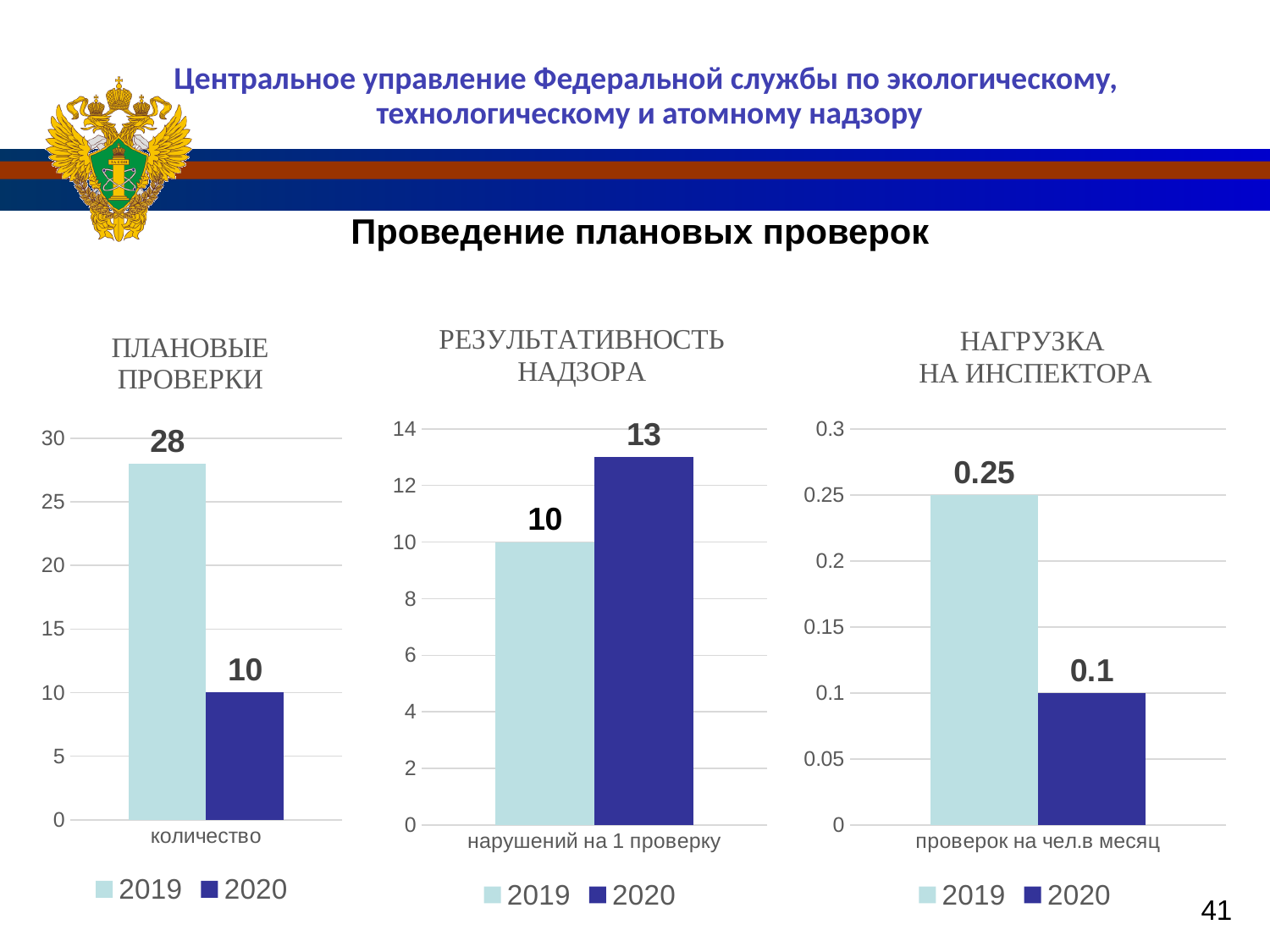
In the chart titled "РЕЗУЛЬТАТИВНОСТЬ НАДЗОРА", what is the difference between the 2020 and 2019 values? 3 In the chart titled "РЕЗУЛЬТАТИВНОСТЬ НАДЗОРА", what is the value for 2020? 13 In the chart titled "ПЛАНОВЫЕ ПРОВЕРКИ", what is the value for 2019? 28 In the chart titled "РЕЗУЛЬТАТИВНОСТЬ НАДЗОРА", which year has the higher value? 2020 How many series does the legend list in the chart titled "ПЛАНОВЫЕ ПРОВЕРКИ"? 2 In the chart titled "НАГРУЗКА НА ИНСПЕКТОРА", what is the category label on the x axis? проверок на чел.в месяц In the chart titled "ПЛАНОВЫЕ ПРОВЕРКИ", what is the difference between the 2019 and 2020 values? 18 In the chart titled "НАГРУЗКА НА ИНСПЕКТОРА", what is the value for 2019? 0.25 In the chart titled "ПЛАНОВЫЕ ПРОВЕРКИ", what is the value for 2020? 10 In the chart titled "НАГРУЗКА НА ИНСПЕКТОРА", which year has the lower value? 2020 What kind of chart is the chart titled "РЕЗУЛЬТАТИВНОСТЬ НАДЗОРА"? Bar chart In the chart titled "НАГРУЗКА НА ИНСПЕКТОРА", what is the value for 2020? 0.1